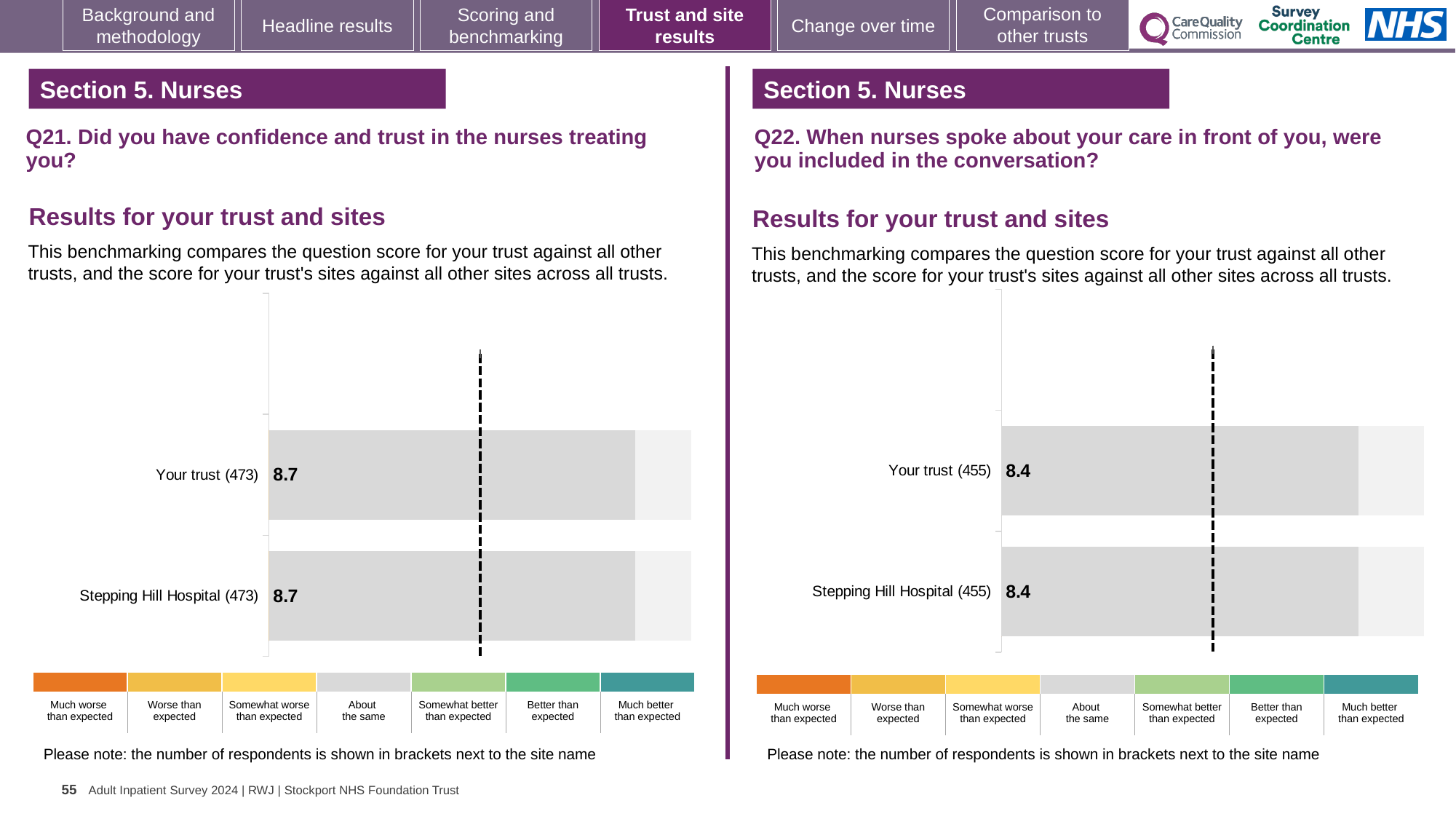
On the Q22 chart (right), how many bars are plotted? 2 On the Q22 chart (right), how many respondents are shown in brackets for Stepping Hill Hospital? 455 On the Q22 chart (right), what is the score for Stepping Hill Hospital? 8.4 On the Q22 chart (right), how many categories does the colour key below the chart list? 7 On the Q22 chart (right), what is the score for Your trust? 8.4 On the Q21 chart (left), how many respondents are shown in brackets for Your trust? 473 On the Q21 chart (left), what is the score for Stepping Hill Hospital? 8.7 Which is larger: the Your trust score on the Q21 chart (left) or the Your trust score on the Q22 chart (right)? Q21 chart (8.7) On the Q21 chart (left), what is the difference between the score for Your trust and the score for Stepping Hill Hospital? 0 On the Q21 chart (left), what is the label of the first bar? Your trust (473) On the Q21 chart (left), what is the score for Your trust? 8.7 What kind of chart is shown on the left for Q21? Bar chart